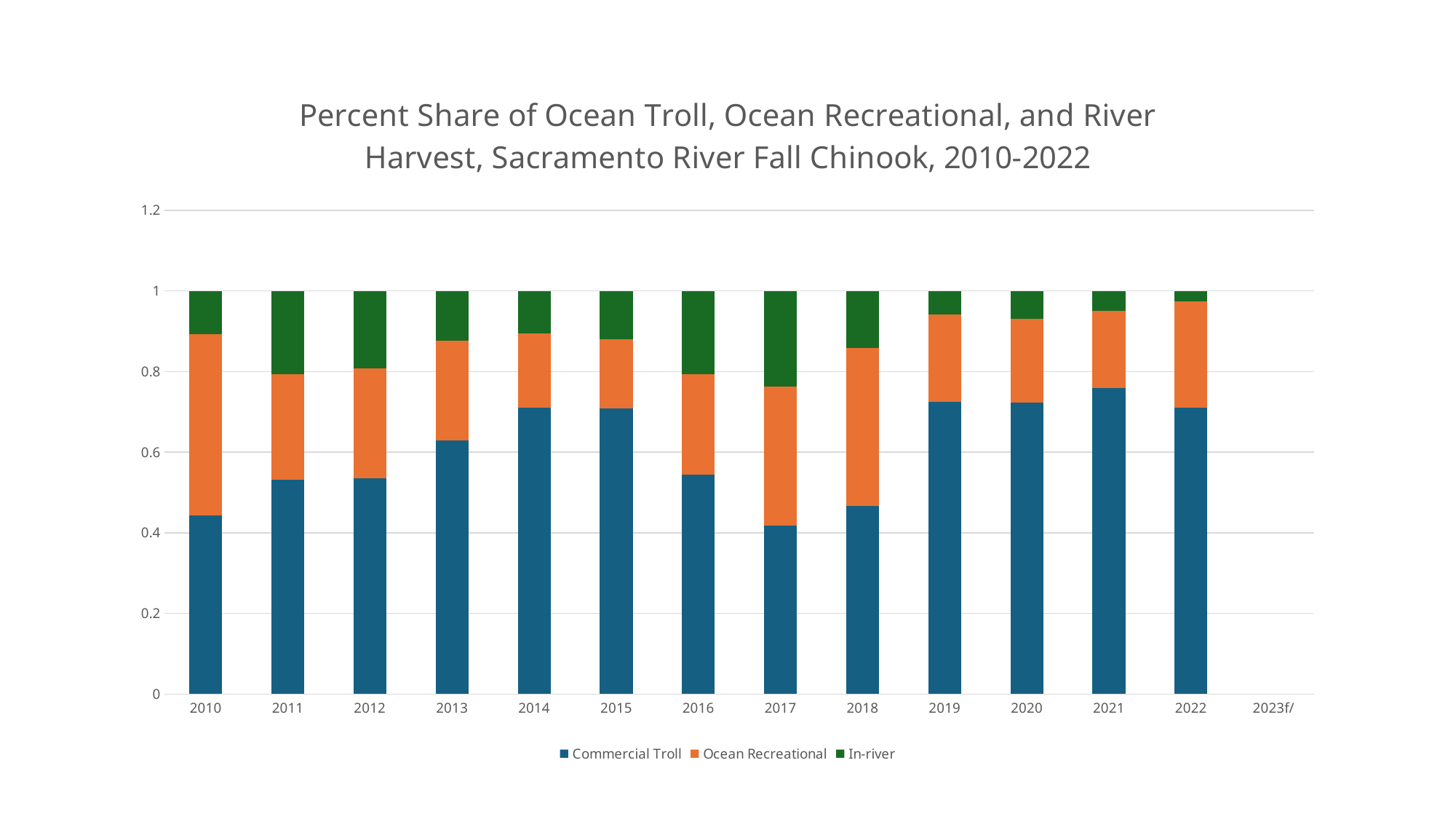
Is the Commercial Troll value for 2010 greater or less than 0.6? less What kind of chart is shown on the slide? Stacked bar chart Which year has the highest Commercial Troll share? 2021 Which year has the smallest In-river share? 2022 How many series does the legend list? 3 How many years have bars plotted on the chart? 13 Which series is shown in orange in the legend? Ocean Recreational Which is larger, the Commercial Troll share in 2013 or in 2016? 2013 Which year has the largest In-river share? 2017 What is the total height of the stacked bar for 2015? 1 Which year has the largest Ocean Recreational share? 2010 Is the Commercial Troll value for 2021 greater or less than 0.6? greater